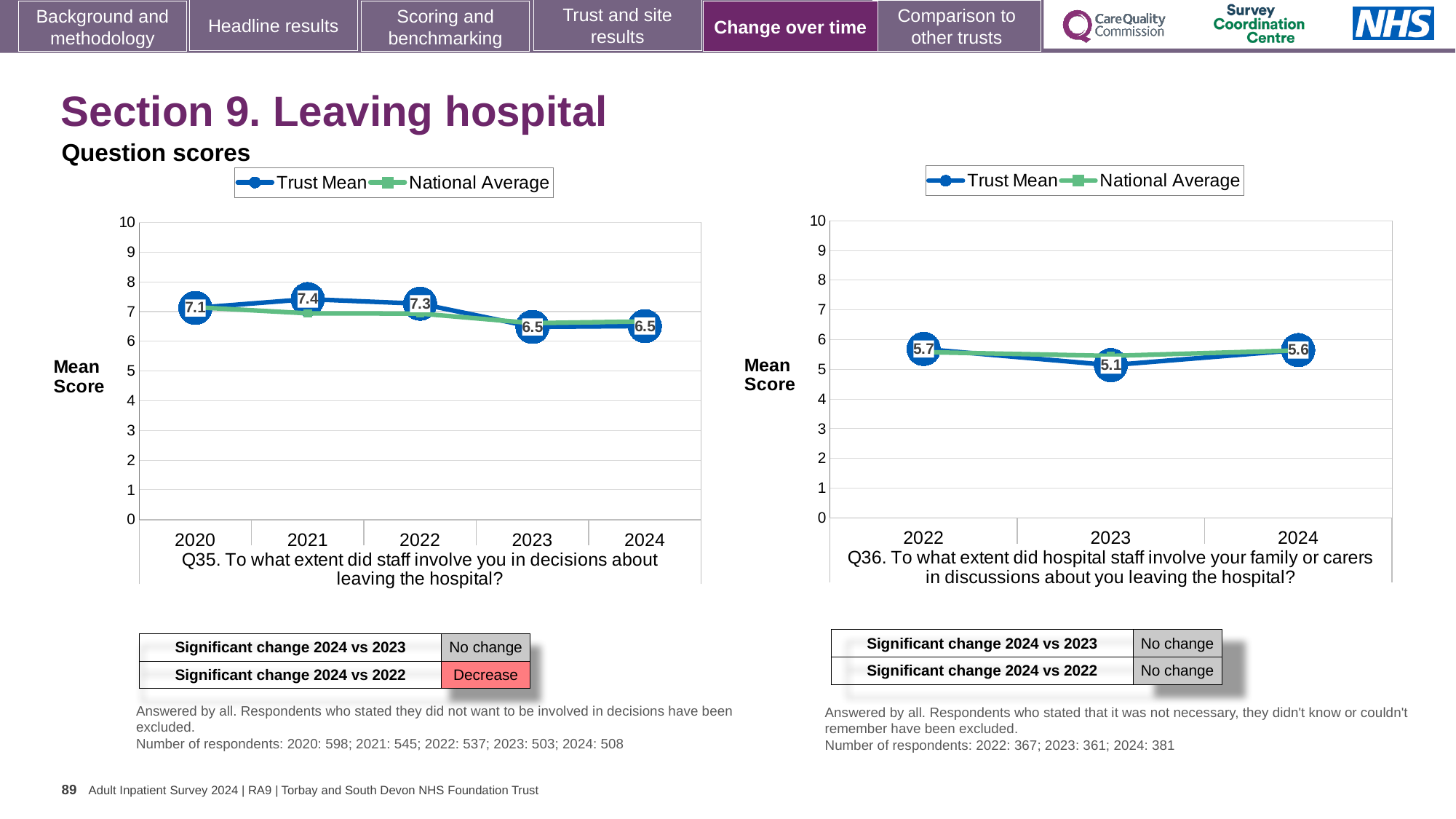
What kind of chart is the Q35 chart (left)? line chart In the Q35 chart (left), what is the Trust Mean for 2024? 6.5 In the Q35 chart (left), what is the difference between the Trust Mean in 2021 and in 2023? 0.9 In the Q36 chart (right), which year has the lowest Trust Mean? 2023 In the Q36 chart (right), what is the Trust Mean for 2023? 5.1 In the Q35 chart (left), does the Trust Mean rise or fall from 2022 to 2023? fall In the Q35 chart (left), what is the Trust Mean for 2021? 7.4 In the Q36 chart (right), is the Trust Mean for 2022 or 2024 larger? 2022 In the Q36 chart (right), is the Trust Mean for 2024 greater or less than 6? less In the Q35 chart (left), how many years are shown on the x axis? 5 How many series does the legend of the Q36 chart (right) list? 2 In the Q35 chart (left), which year has the highest Trust Mean? 2021